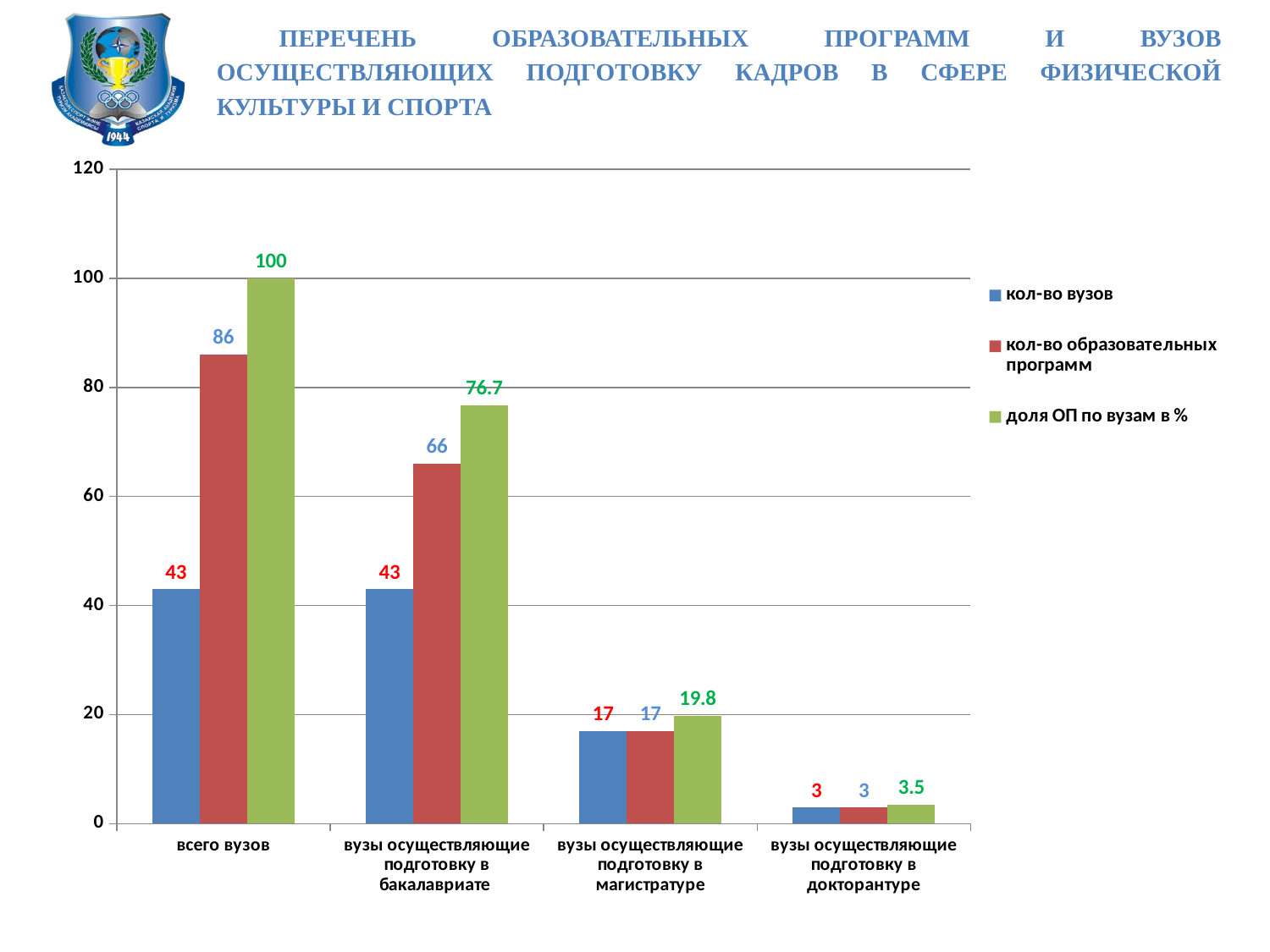
What is the value of "кол-во вузов" for "вузы осуществляющие подготовку в магистратуре"? 17 What is the value of "кол-во образовательных программ" for "всего вузов"? 86 What is the value of "доля ОП по вузам в %" for "вузы осуществляющие подготовку в докторантуре"? 3.5 Which colour represents the series "доля ОП по вузам в %" in the legend? green Which is larger: "кол-во образовательных программ" for "вузы осуществляющие подготовку в бакалавриате" or for "вузы осуществляющие подготовку в магистратуре"? вузы осуществляющие подготовку в бакалавриате What kind of chart is shown on the slide? bar chart What is the difference between "кол-во образовательных программ" for "всего вузов" and for "вузы осуществляющие подготовку в бакалавриате"? 20 How many categories are shown on the x axis? 4 What is the value of "доля ОП по вузам в %" for "вузы осуществляющие подготовку в бакалавриате"? 76.7 How many series does the legend list? 3 Which category has the highest value for "доля ОП по вузам в %"? всего вузов Which category has the lowest value for "кол-во образовательных программ"? вузы осуществляющие подготовку в докторантуре